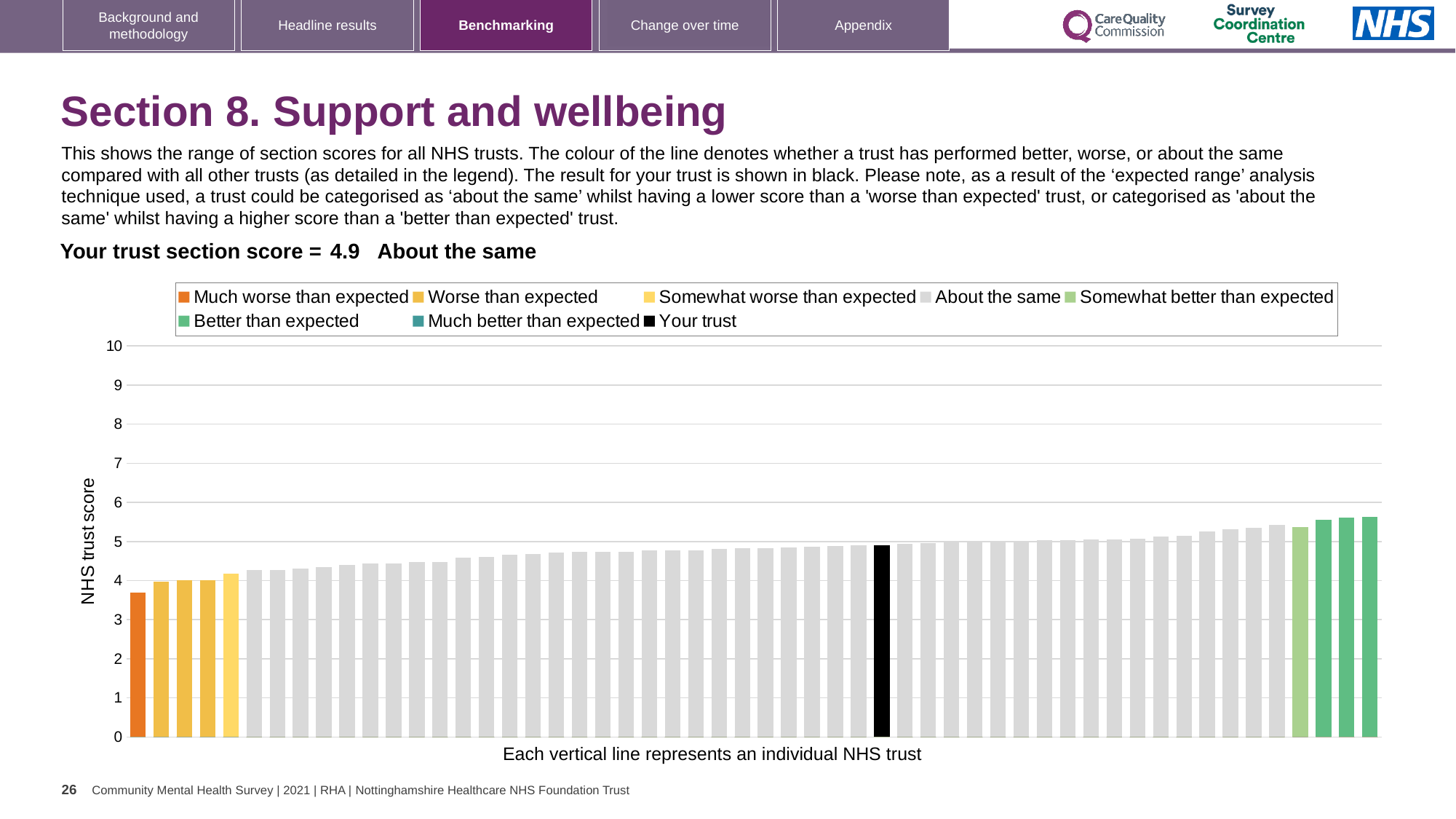
What kind of chart is shown on the slide? Bar chart Do the bar values rise or fall from left to right along the x axis? rise Is the value for your trust (the black bar) greater or less than 4? greater How is your trust categorised compared with other trusts, according to the text above the chart? About the same What colour is used for the bar representing your trust? Black What is the label on the y axis of the chart? NHS trust score Is the value of the rightmost bar greater or less than 6? less Is the value of the leftmost (orange) bar greater or less than 4? less What is the section score for your trust shown on the slide? 4.9 Which legend category does the lowest bar on the chart belong to? Much worse than expected Which is higher: the leftmost bar or the rightmost bar? the rightmost bar How many entries does the chart legend list? 8